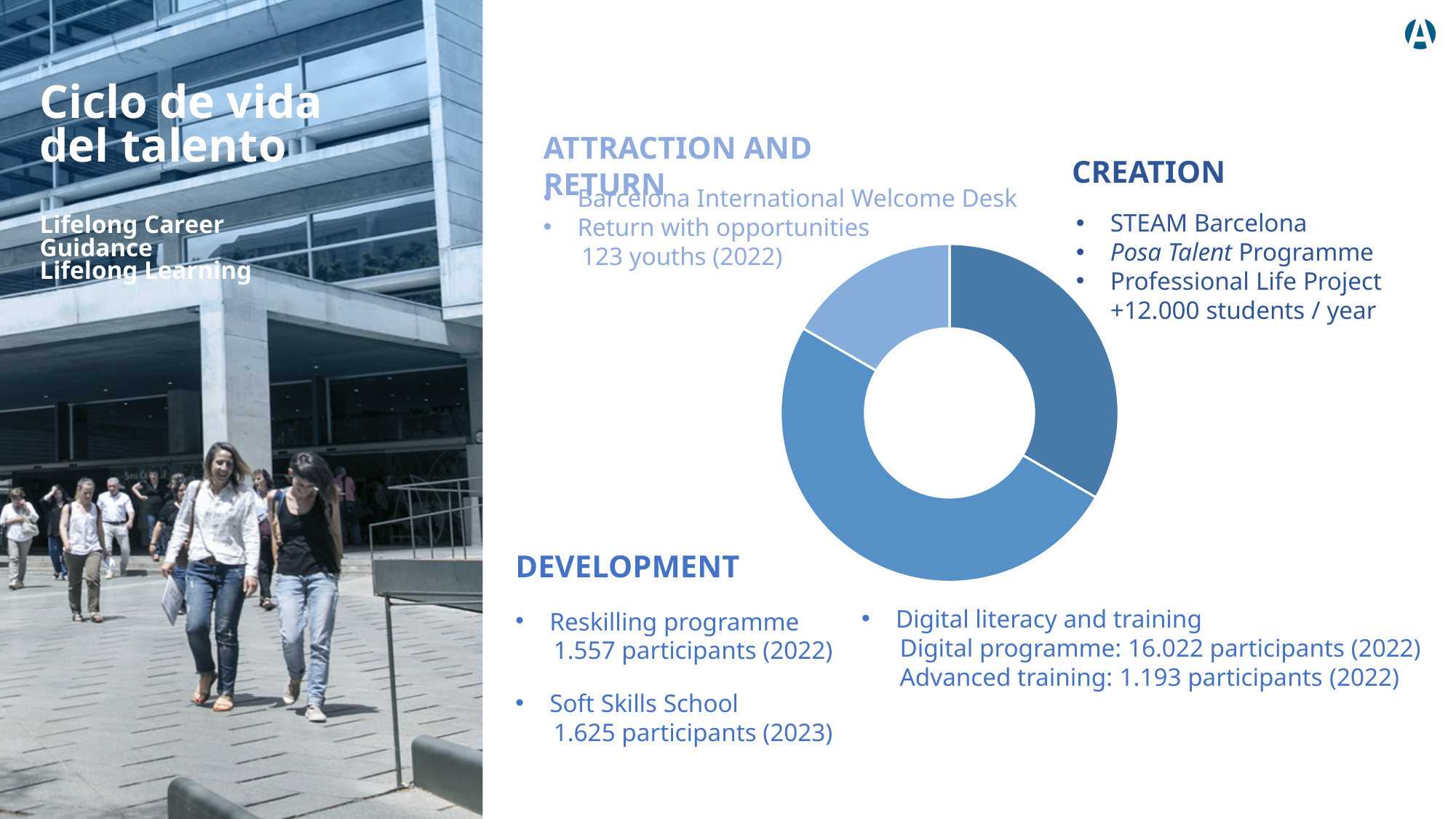
Which slice of the doughnut chart is the smallest? The light blue slice (top left) Does the doughnut chart include a legend? No Does the doughnut chart display data labels with values on its slices? No How many slices does the doughnut chart have? 3 Is the light blue slice of the doughnut chart larger or smaller than the dark blue slice? Smaller What kind of chart is shown on the slide? Doughnut chart